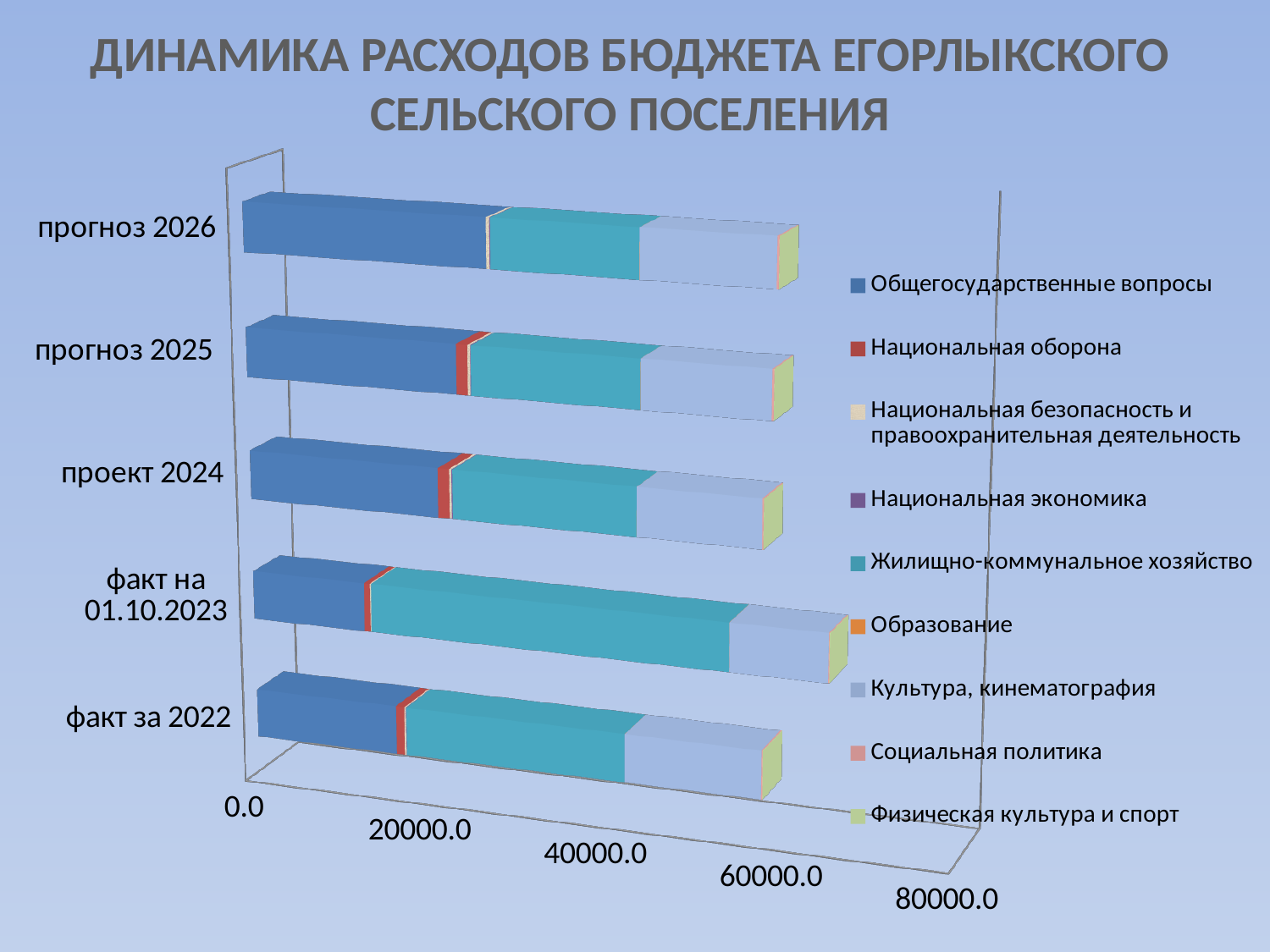
Which category has the longest total bar? факт на 01.10.2023 Which series is listed first in the legend? Общегосударственные вопросы How many categories (budget periods) are shown on the chart? 5 What type of chart is shown on the slide? Stacked bar chart What is the title of the chart? ДИНАМИКА РАСХОДОВ БЮДЖЕТА ЕГОРЛЫКСКОГО СЕЛЬСКОГО ПОСЕЛЕНИЯ Is the total value for факт за 2022 greater or less than 80000.0? less How many series does the legend list? 9 Which is larger: the Общегосударственные вопросы segment for прогноз 2026 or for факт на 01.10.2023? прогноз 2026 Which is larger: the Жилищно-коммунальное хозяйство segment for факт на 01.10.2023 or for факт за 2022? факт на 01.10.2023 Is the total value for прогноз 2026 greater or less than 40000.0? greater Is the total value for факт на 01.10.2023 greater or less than 60000.0? greater